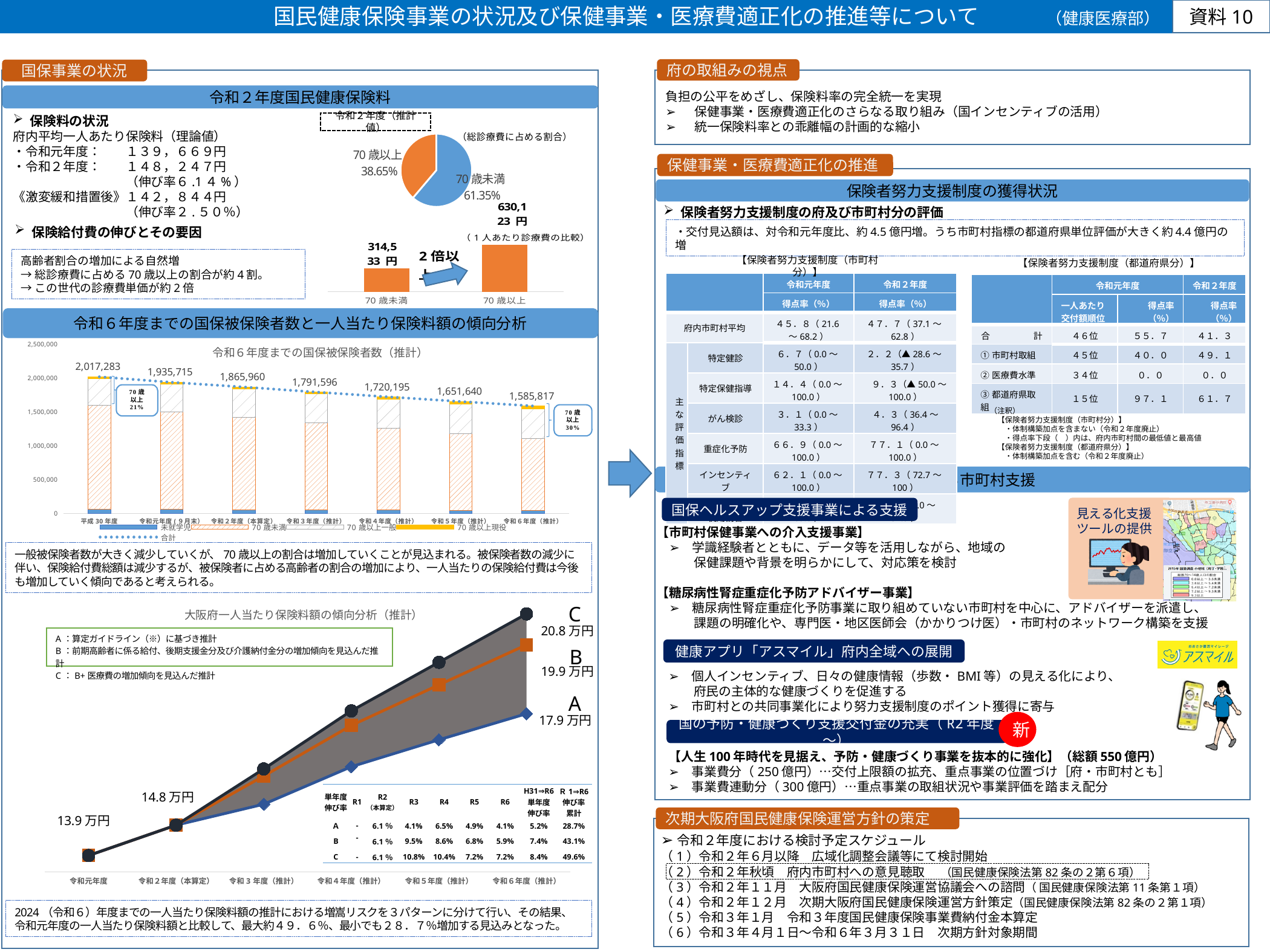
In the pie chart showing the share of total medical costs (総診療費に占める割合), what is the share for 70歳未満? 61.35% In the chart 令和6年度までの国保被保険者数（推計）, what is the total number of insured persons for 平成30年度? 2,017,283 In the bar chart comparing per-person medical costs, which category has the higher value? 70歳以上 In the chart 大阪府一人当たり保険料額の傾向分析（推計）, which scenario (A, B or C) reaches the highest value in 令和6年度? C In the bar chart comparing per-person medical costs (1人当たり診療費の比較), what is the value for 70歳未満? 314,533円 In the chart 令和6年度までの国保被保険者数（推計）, do the total values rise or fall from 平成30年度 to 令和6年度? fall In the bar chart comparing per-person medical costs (1人当たり診療費の比較), what is the value for 70歳以上? 630,123円 In the chart 令和6年度までの国保被保険者数（推計）, what is the total number of insured persons for 令和6年度（推計）? 1,585,817 In the pie chart showing the share of total medical costs, which slice is larger, 70歳以上 or 70歳未満? 70歳未満 In the chart 令和6年度までの国保被保険者数（推計）, how many fiscal years are plotted on the x axis? 7 In the chart 大阪府一人当たり保険料額の傾向分析（推計）, what is the value for 令和元年度? 13.9万円 In the pie chart showing the share of total medical costs (総診療費に占める割合), what is the share for 70歳以上? 38.65%